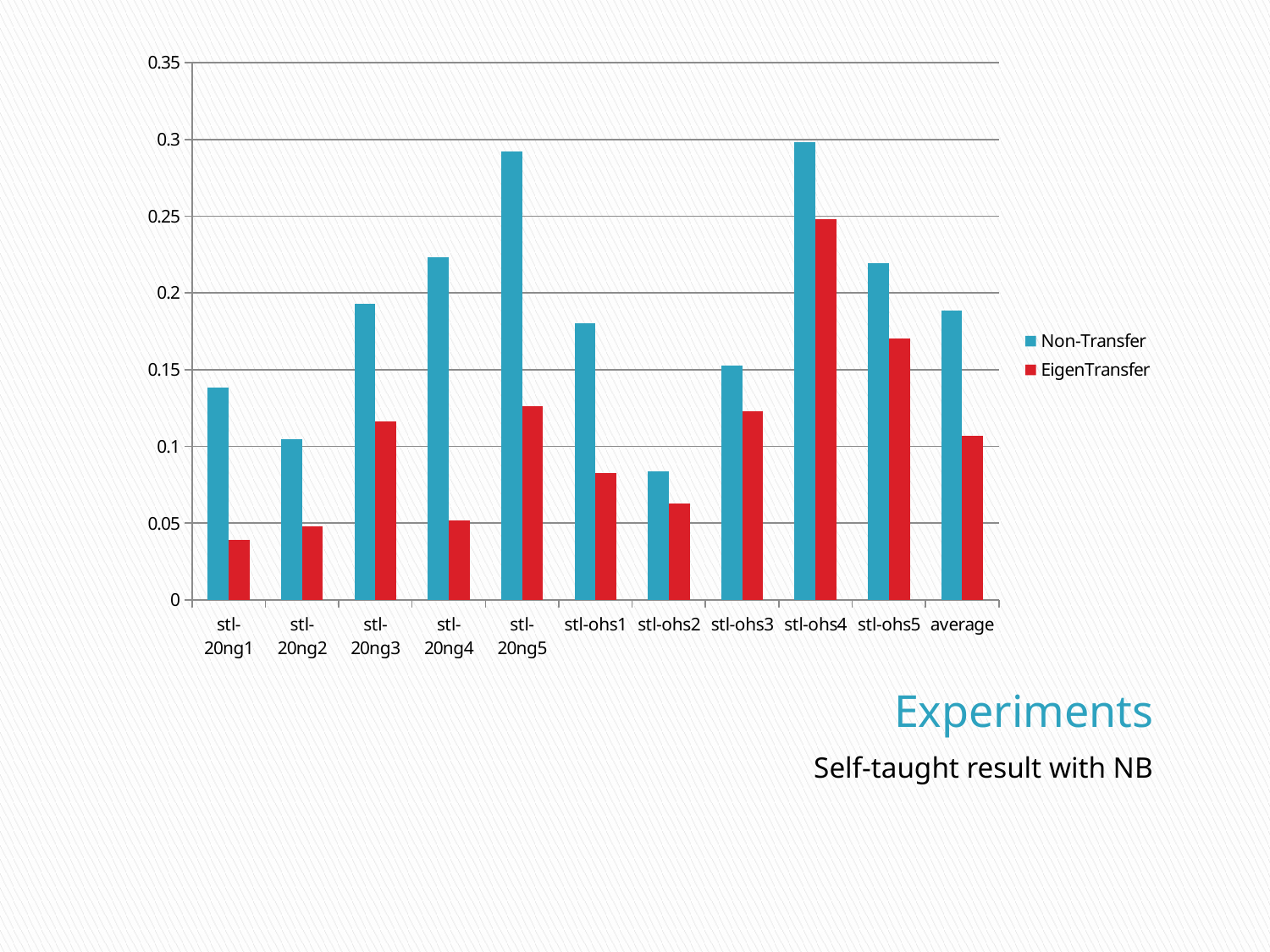
Is the EigenTransfer value for stl-20ng1 greater or less than 0.05? less Is the Non-Transfer value for stl-ohs2 greater or less than 0.1? less How many series does the legend list? 2 What kind of chart is shown on the slide? bar chart Which category has the lowest Non-Transfer value? stl-ohs2 Which category has the highest EigenTransfer value? stl-ohs4 For the average category, which series has the larger value, Non-Transfer or EigenTransfer? Non-Transfer Which colour represents the EigenTransfer series in the legend? red Is the Non-Transfer value for stl-20ng4 greater or less than 0.2? greater How many categories are shown along the x axis? 11 Which is larger: the EigenTransfer value for stl-ohs3 or the EigenTransfer value for stl-20ng4? stl-ohs3